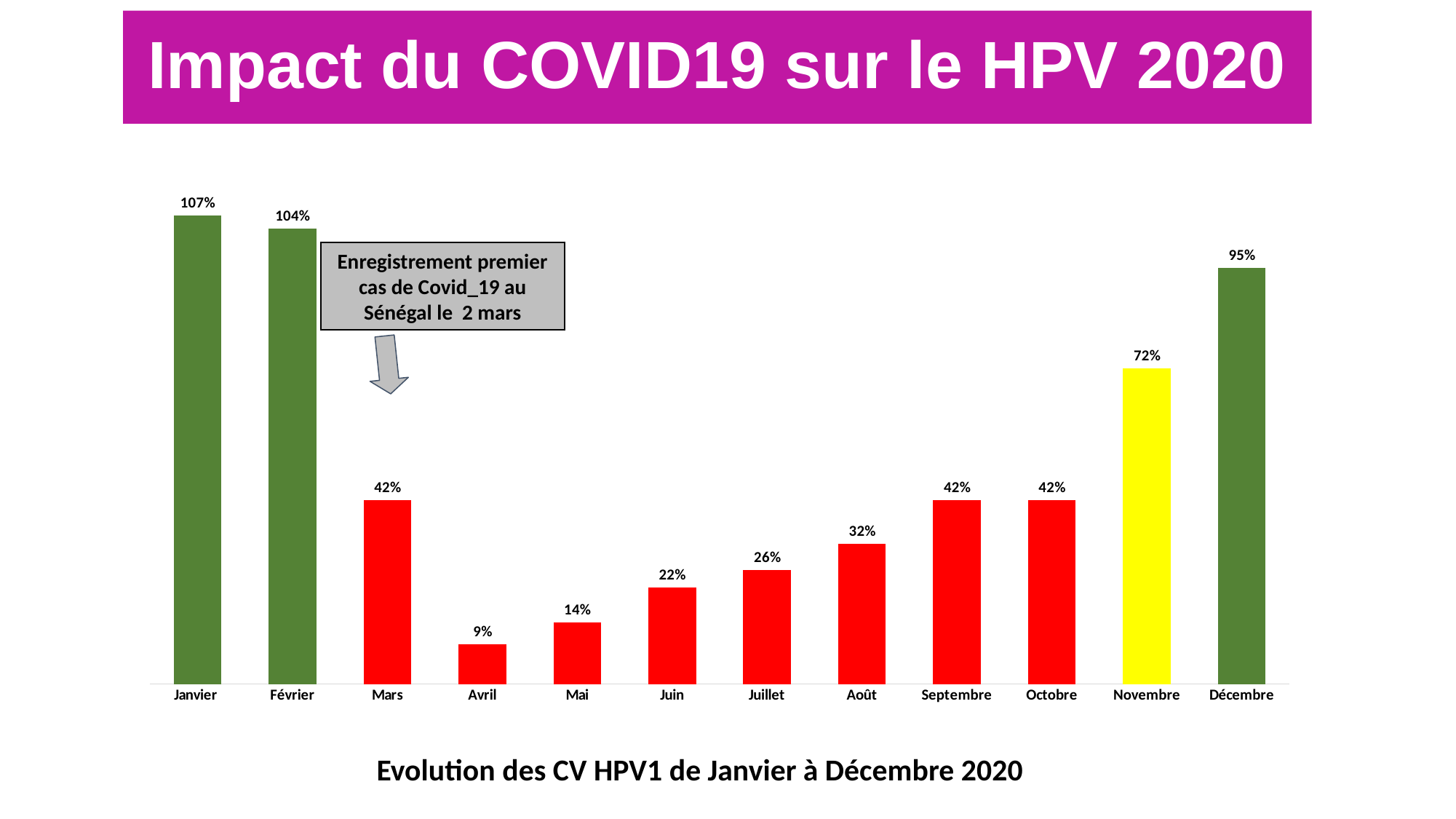
Which is larger, the value for Juin or the value for Juillet? Juillet What is the value for Janvier? 107% What is the difference between the values for Décembre and Novembre? 23% Which month has the highest value? Janvier What is the value for Novembre? 72% What kind of chart is shown on the slide? Bar chart What is the value for Avril? 9% What is the value for Août? 32% How many months are shown on the x axis? 12 Which month has the lowest value? Avril What is the difference between the values for Février and Mars? 62% Do the values rise or fall from Avril to Septembre? Rise